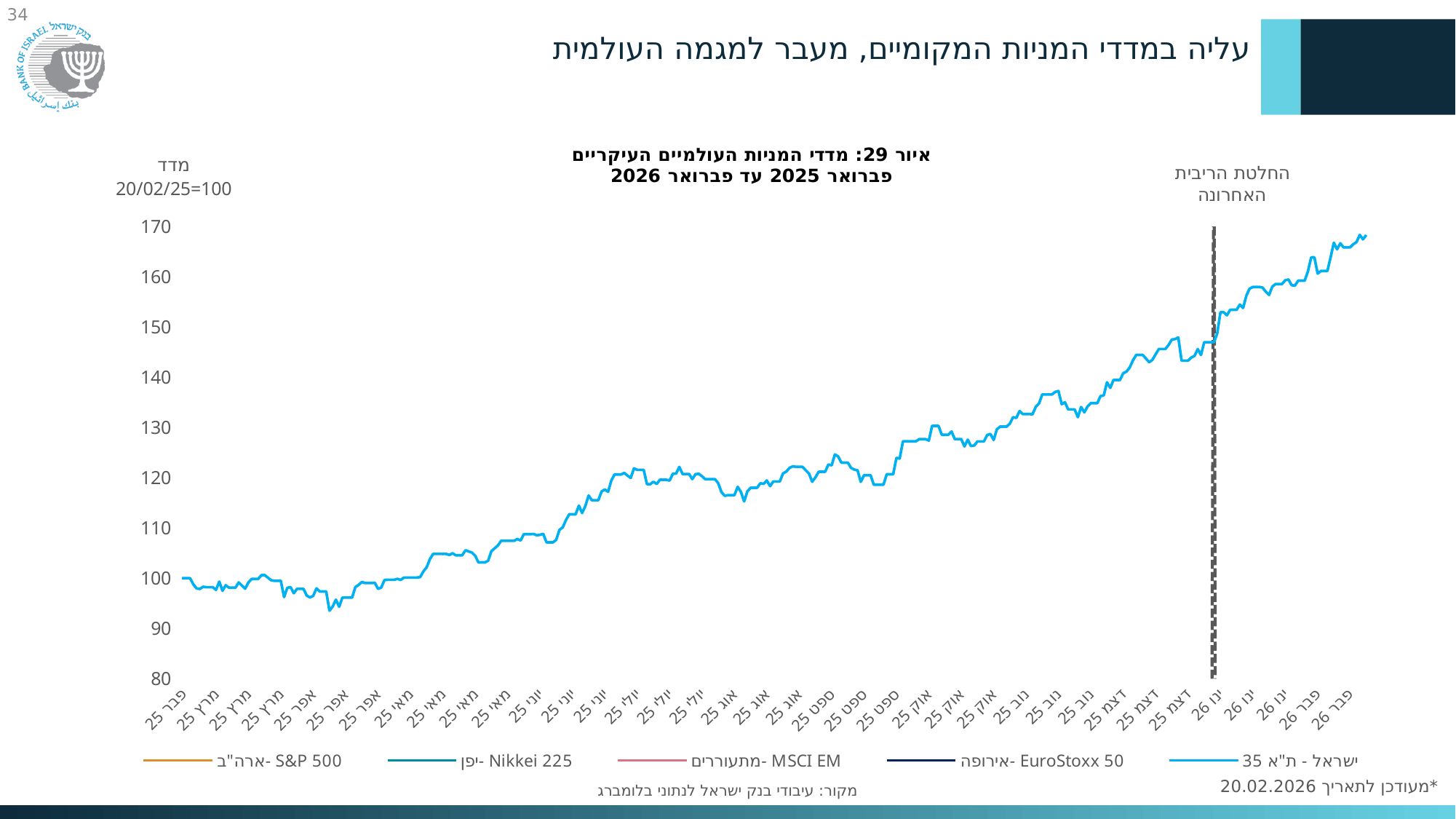
Is the value of the TA-35 line at the end of the chart (February 2026) greater or less than 160? greater What base value does the index use, according to the y-axis label? 20/02/25=100 What does the vertical dashed line on the chart mark? החלטת הריבית האחרונה Does the plotted TA-35 (ישראל - ת"א 35) line generally rise or fall from February 2025 to February 2026? rise How many series does the legend list? 5 What kind of chart is shown on the slide? line chart Is the value of the TA-35 line in August 2025 greater or less than 110? greater Is the value of the TA-35 line in August 2025 greater or less than 130? less What is the highest value shown on the y axis? 170